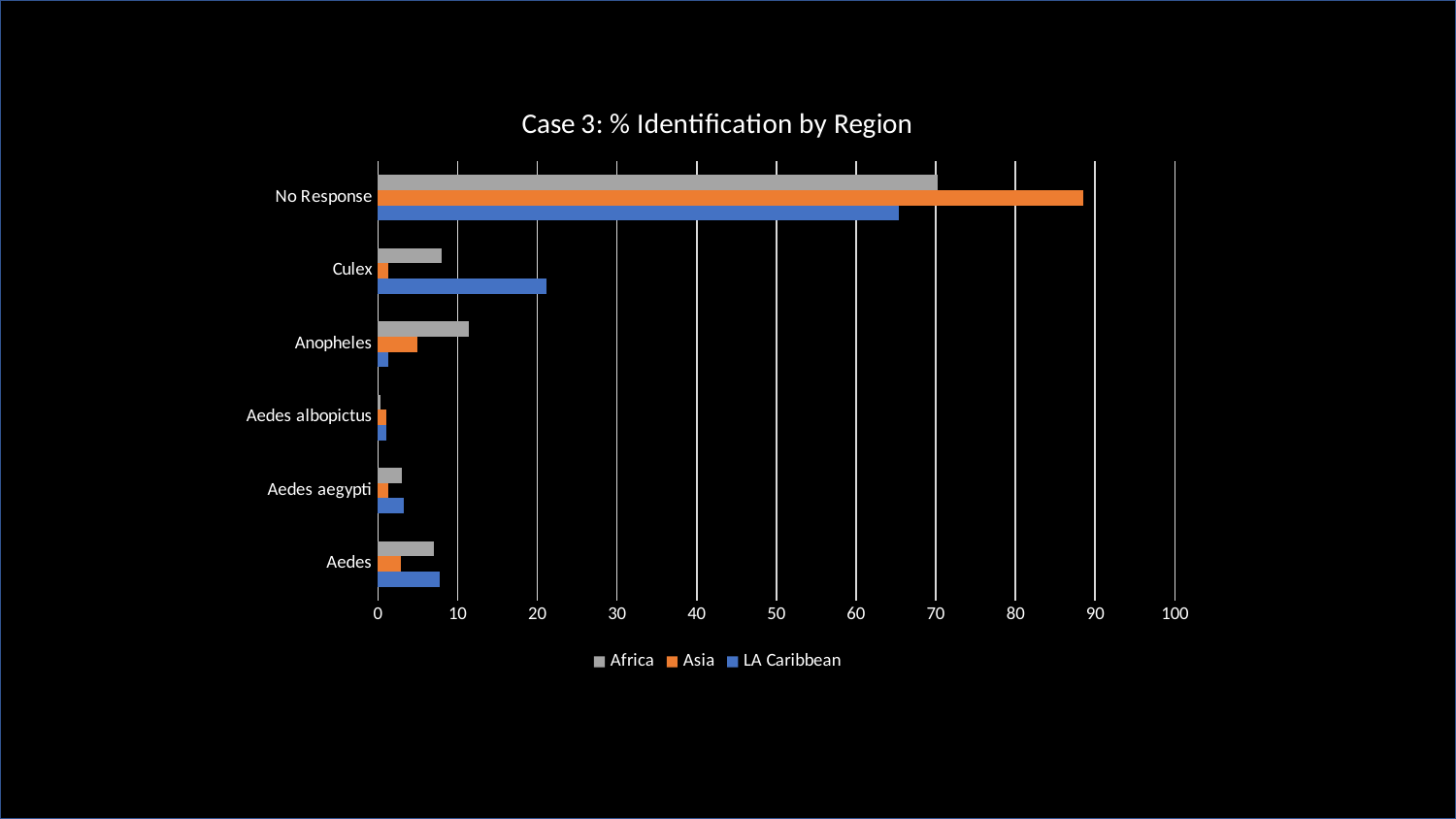
Is the LA Caribbean value for Culex greater or less than 10? greater Which colour represents the Asia series in the legend? Orange For Culex, which is larger: the Africa value or the LA Caribbean value? LA Caribbean Which category has the highest value for the Asia series? No Response For No Response, which is larger: the Asia value or the LA Caribbean value? Asia Is the Asia value for No Response greater or less than 80? greater Is the Africa value for No Response greater or less than 60? greater What kind of chart is shown on the slide? Bar chart How many series does the legend list? 3 How many categories are shown on the vertical axis? 6 What is the title of the chart? Case 3: % Identification by Region For Anopheles, which is larger: the Africa value or the Asia value? Africa